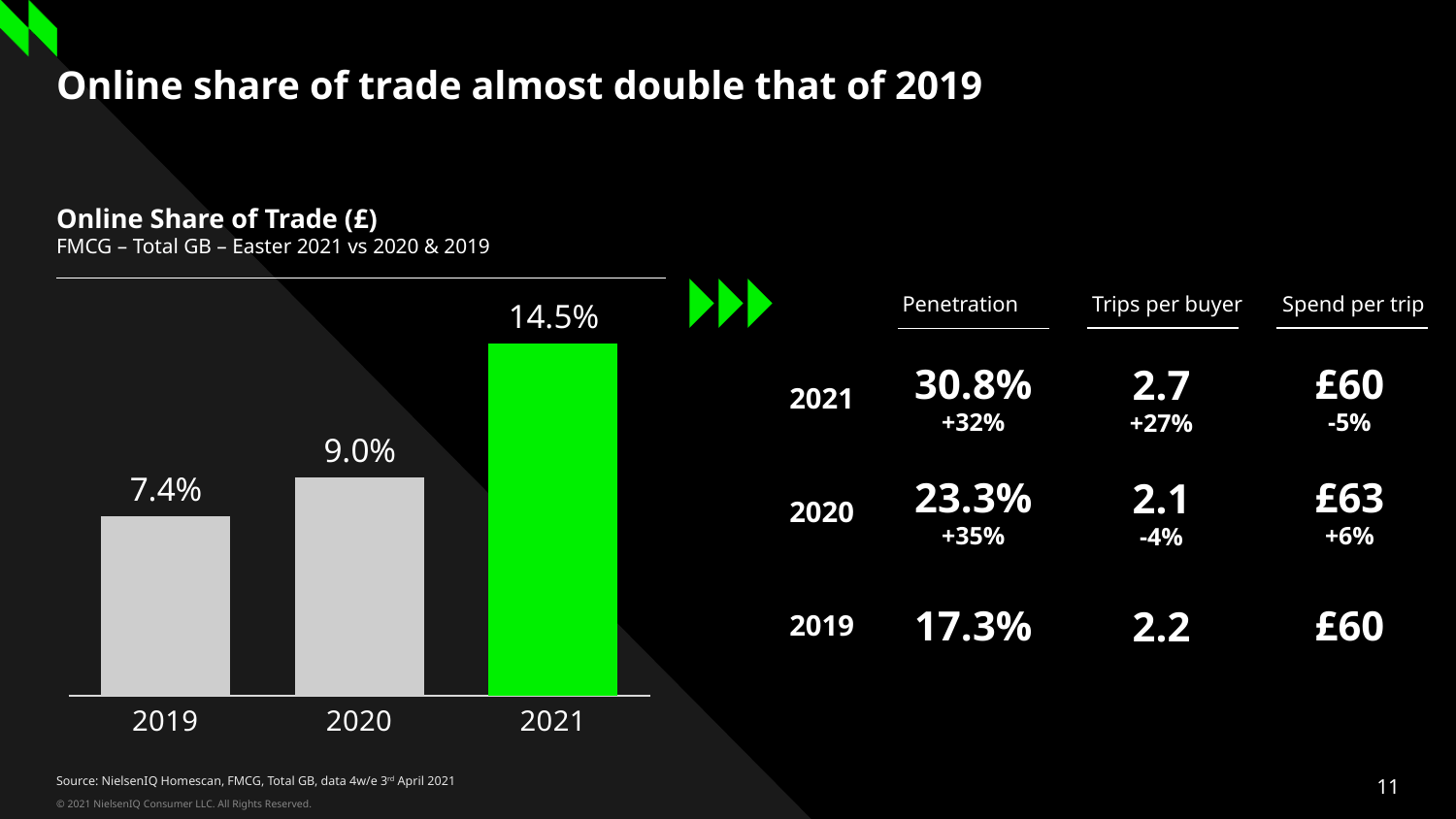
What is the difference in online share of trade between 2021 and 2019? 7.1 percentage points How many years are shown in the bar chart? 3 Does the online share of trade rise or fall from 2019 to 2021? Rise Which year has the lowest online share of trade? 2019 What is the title of the chart? Online Share of Trade (£) What is the difference in online share of trade between 2020 and 2019? 1.6 percentage points Which year has the highest online share of trade? 2021 What is the online share of trade for 2021? 14.5% What is the online share of trade for 2019? 7.4% Which is larger, the online share of trade in 2020 or in 2021? 2021 What is the online share of trade for 2020? 9.0% What type of chart is used to show the online share of trade? Bar chart